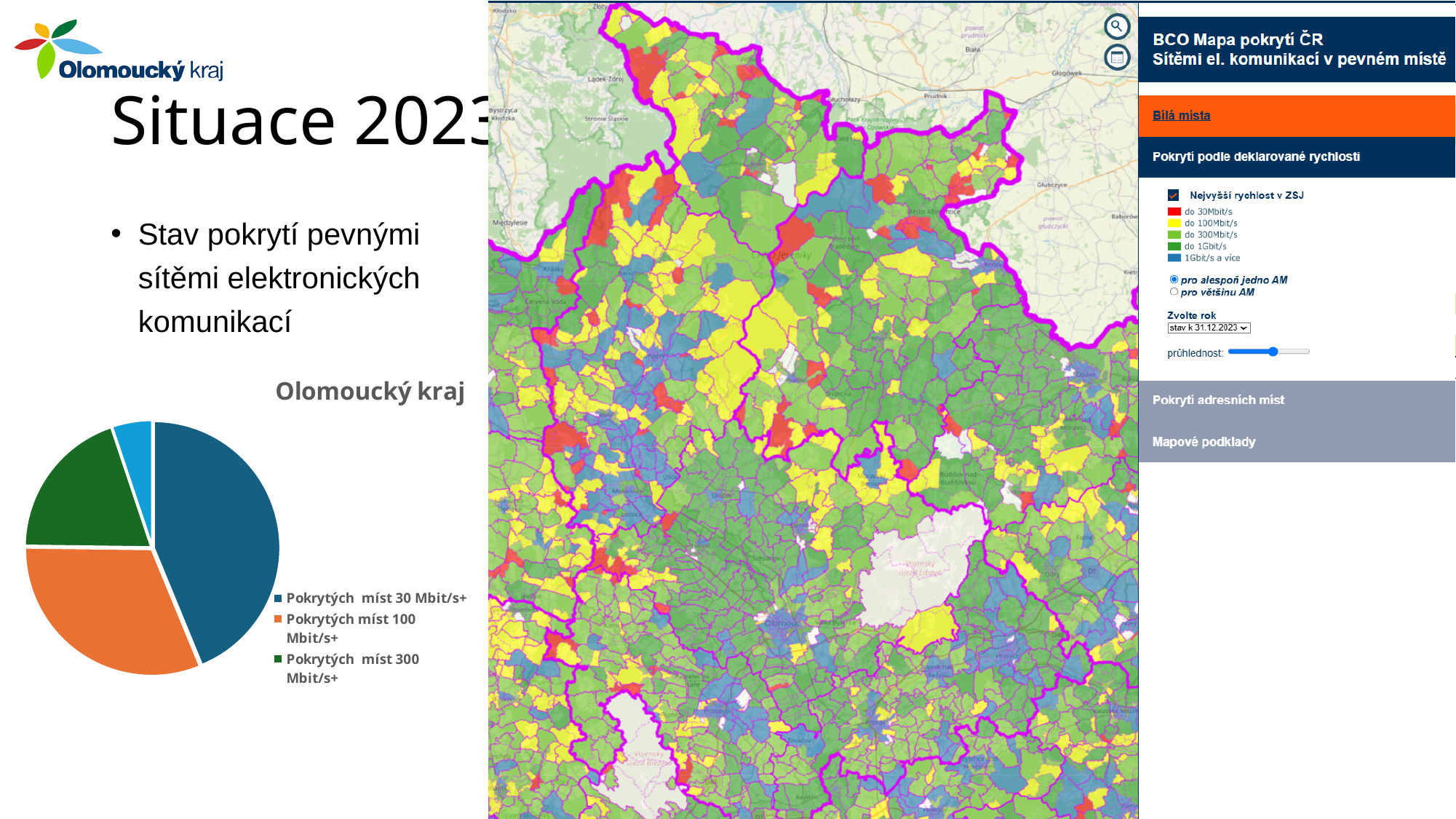
Which of the three legend categories has the smallest slice in the pie chart? Pokrytých míst 300 Mbit/s+ Which slice is larger in the pie chart: Pokrytých míst 100 Mbit/s+ or Pokrytých míst 300 Mbit/s+? Pokrytých míst 100 Mbit/s+ Which slice is larger in the pie chart: Pokrytých míst 30 Mbit/s+ or Pokrytých míst 100 Mbit/s+? Pokrytých míst 30 Mbit/s+ How many entries does the legend of the pie chart list? 3 Which legend category has the largest slice in the pie chart? Pokrytých míst 30 Mbit/s+ What kind of chart is shown on the slide? pie chart How many slices does the pie chart have? 4 What is the title of the pie chart? Olomoucký kraj What colour represents Pokrytých míst 100 Mbit/s+ in the pie chart? orange